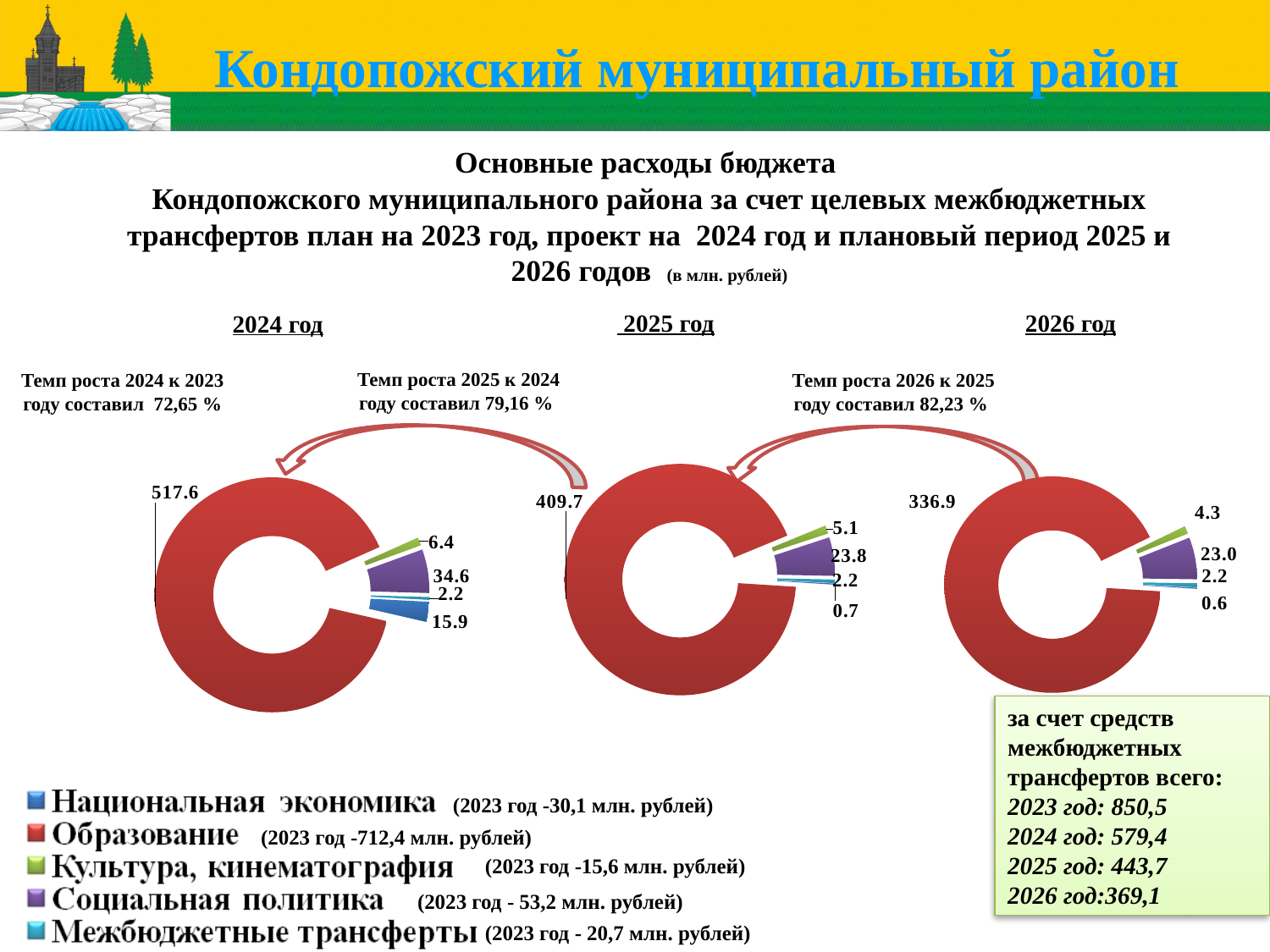
In the 2024 год chart, what is the value for Социальная политика? 34.6 In the 2026 год chart, what is the value for Образование? 336.9 In the 2024 год chart, which is larger: Социальная политика or Культура, кинематография? Социальная политика In the 2026 год chart, what is the value for Культура, кинематография? 4.3 In the 2025 год chart, what is the value for Образование? 409.7 How much larger is the Образование value in the 2024 год chart than in the 2025 год chart? 107.9 How many categories does the legend list for the charts? 5 What kind of chart is used to show the 2024 год budget expenditures? Doughnut (pie) chart In the 2024 год chart, which category has the largest value? Образование In the 2025 год chart, what is the value for Социальная политика? 23.8 In the 2024 год chart, what is the value for Образование? 517.6 In the 2025 год chart, what is the difference between Социальная политика and Культура, кинематография? 18.7